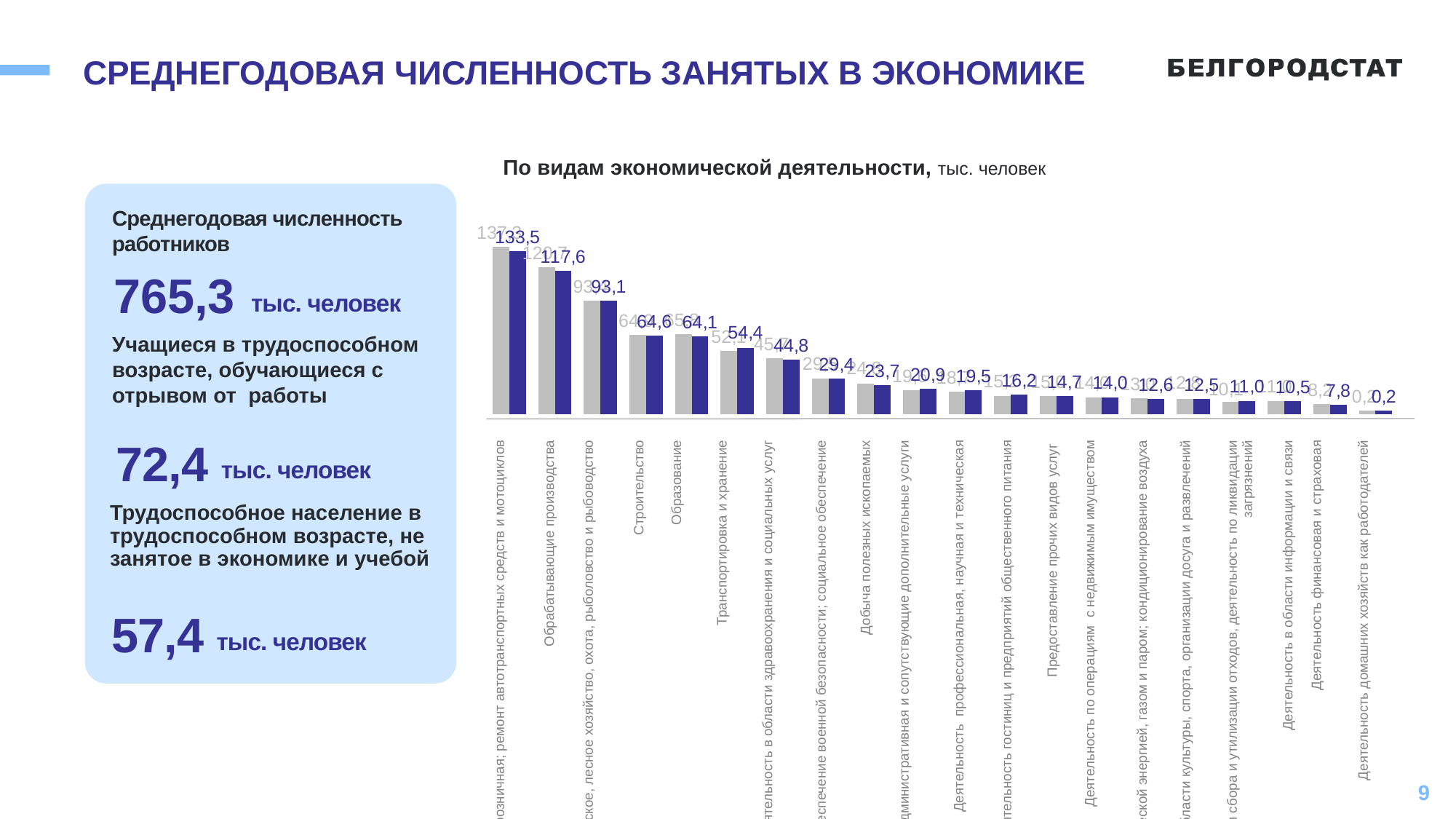
What is the difference between the blue bars for Строительство and Образование? 0,5 Which category has the lowest blue bar? Деятельность домашних хозяйств как работодателей Do the blue bar values rise or fall from left to right along the x axis? fall What is the value of the blue bar for Строительство? 64,6 How many categories are shown on the x axis of the chart? 20 What is the value of the blue bar for Добыча полезных ископаемых? 23,7 What kind of chart is shown on the slide? bar chart What is the value of the blue bar for Транспортировка и хранение? 54,4 Which blue bar is larger: Обрабатывающие производства or Строительство? Обрабатывающие производства What is the value of the blue bar for Деятельность финансовая и страховая? 7,8 What is the value of the blue bar for Образование? 64,1 What is the value of the blue bar for Обрабатывающие производства? 117,6